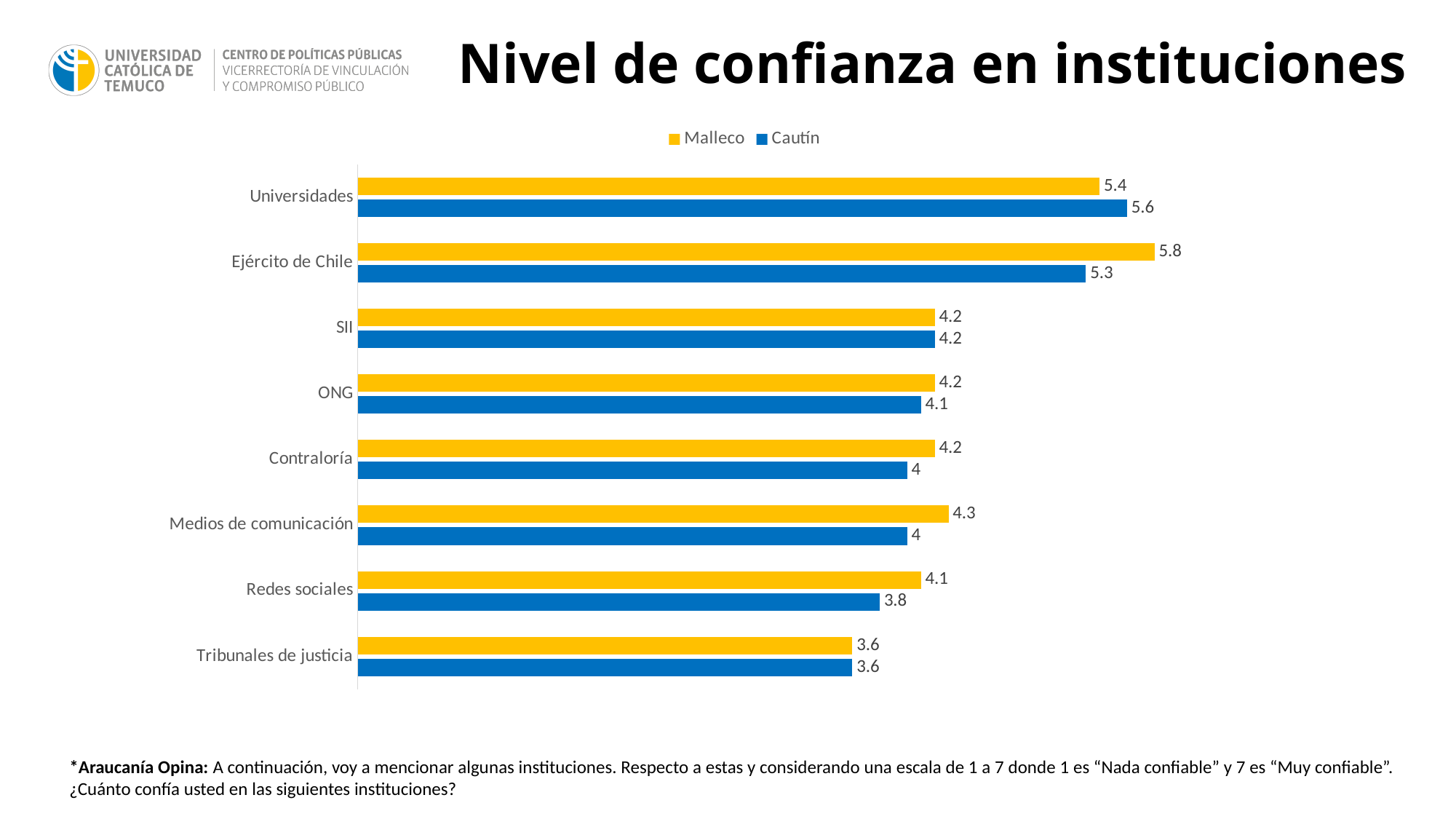
For Universidades, which is larger: the Malleco value or the Cautín value? Cautín What is the difference between the Malleco and Cautín values for Ejército de Chile? 0.5 What is the title of the chart? Nivel de confianza en instituciones What is the Malleco value for Ejército de Chile? 5.8 How many institutions are shown on the chart? 8 What is the Cautín value for Redes sociales? 3.8 How many series does the legend list? 2 What kind of chart is shown on the slide? Bar chart Which institution has the highest Malleco value? Ejército de Chile What is the Cautín value for Universidades? 5.6 Which institution has the lowest Cautín value? Tribunales de justicia What is the Malleco value for Medios de comunicación? 4.3